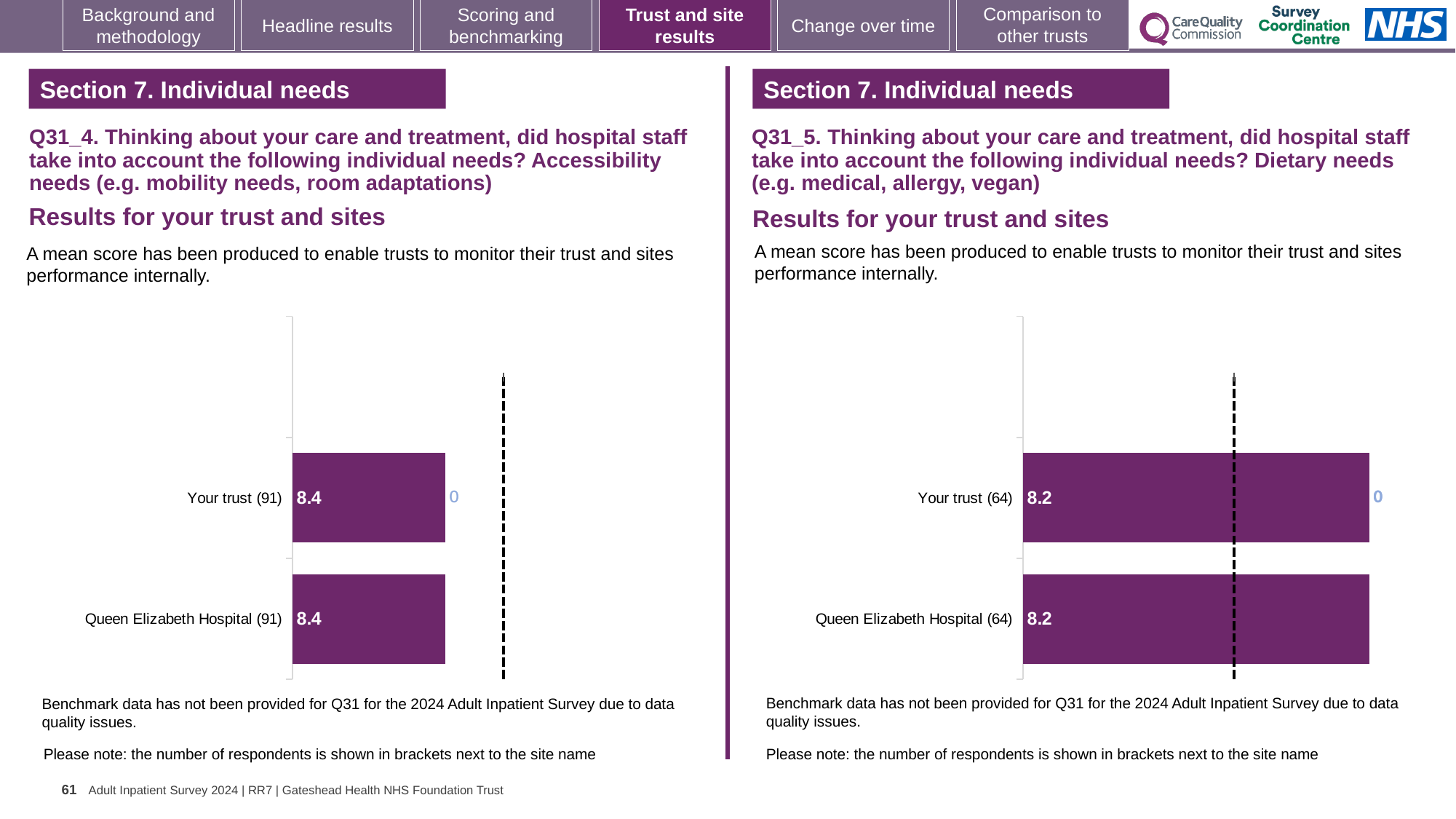
On the right chart (Q31_5, dietary needs), how many respondents are shown in brackets for Your trust? 64 On the left chart (Q31_4, accessibility needs), what is the mean score for Queen Elizabeth Hospital (91)? 8.4 How many bars are plotted on the right chart (Q31_5, dietary needs)? 2 On the left chart (Q31_4, accessibility needs), what is the mean score for Your trust (91)? 8.4 On the left chart (Q31_4, accessibility needs), how many respondents are shown in brackets for Queen Elizabeth Hospital? 91 How many bars are plotted on the left chart (Q31_4, accessibility needs)? 2 What kind of chart is used on the left (Q31_4, accessibility needs)? Bar chart On the right chart (Q31_5, dietary needs), what is the difference between the scores for Your trust and Queen Elizabeth Hospital? 0 On the right chart (Q31_5, dietary needs), what is the mean score for Queen Elizabeth Hospital (64)? 8.2 On the right chart (Q31_5, dietary needs), what is the mean score for Your trust (64)? 8.2 On the left chart (Q31_4, accessibility needs), what is the difference between the scores for Your trust and Queen Elizabeth Hospital? 0